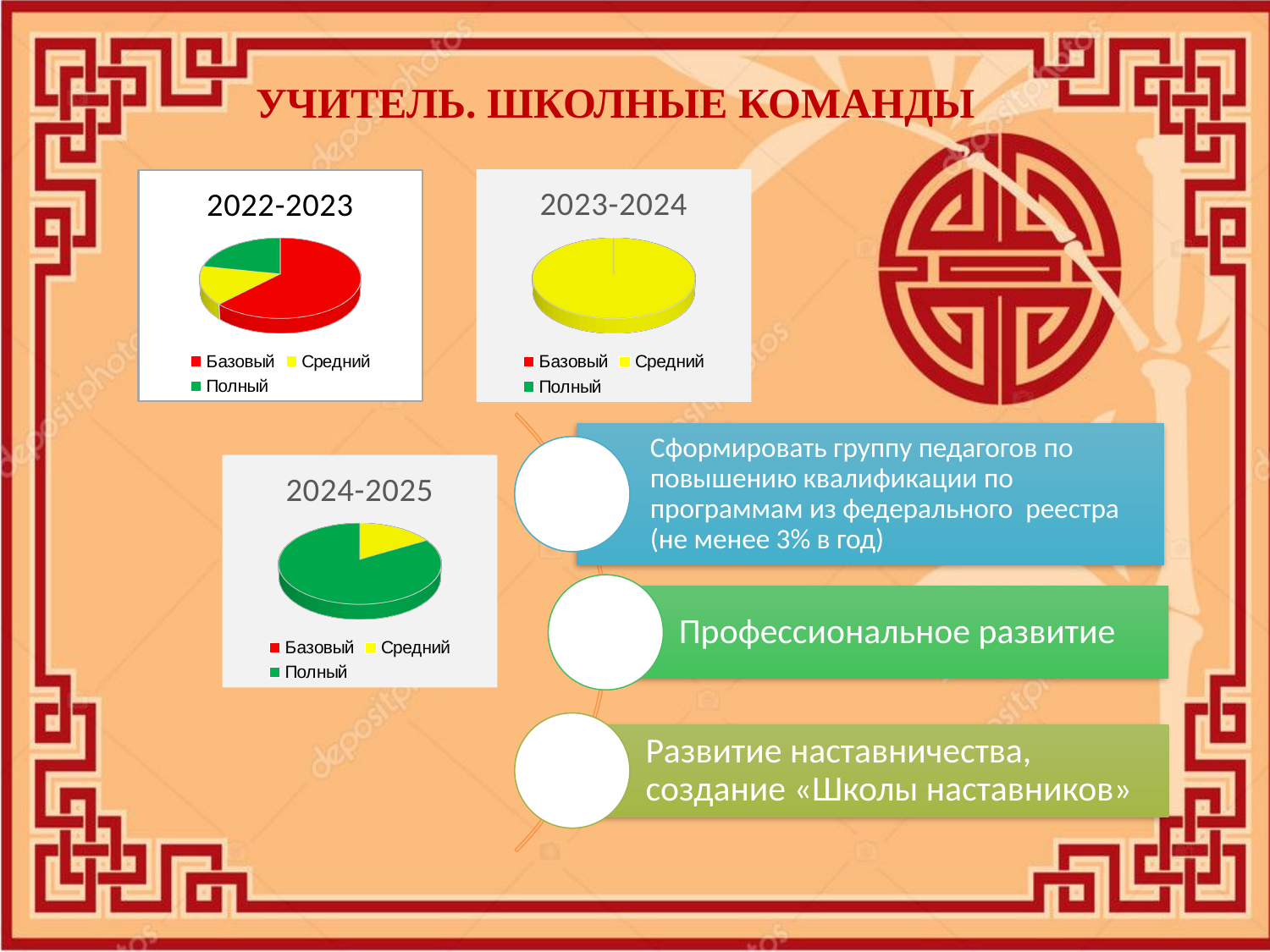
In the 2024-2025 chart, which category has the largest slice? Полный What is the title of the pie chart in the bottom-left of the slide? 2024-2025 What kind of chart is the 2022-2023 chart? pie chart What colour represents Полный in the legends of the charts? green In the 2022-2023 chart, which category has the largest slice? Базовый In the 2024-2025 chart, which category has the smallest visible slice? Средний In the 2023-2024 chart, which category takes up the whole pie? Средний How many pie charts are shown on the slide? 3 In the 2024-2025 chart, which is larger: Полный or Средний? Полный How many entries does the legend of the 2022-2023 chart list? 3 In the 2022-2023 chart, which is larger: Базовый or Полный? Базовый In the 2022-2023 chart, is the Базовый slice greater or less than half of the pie? greater